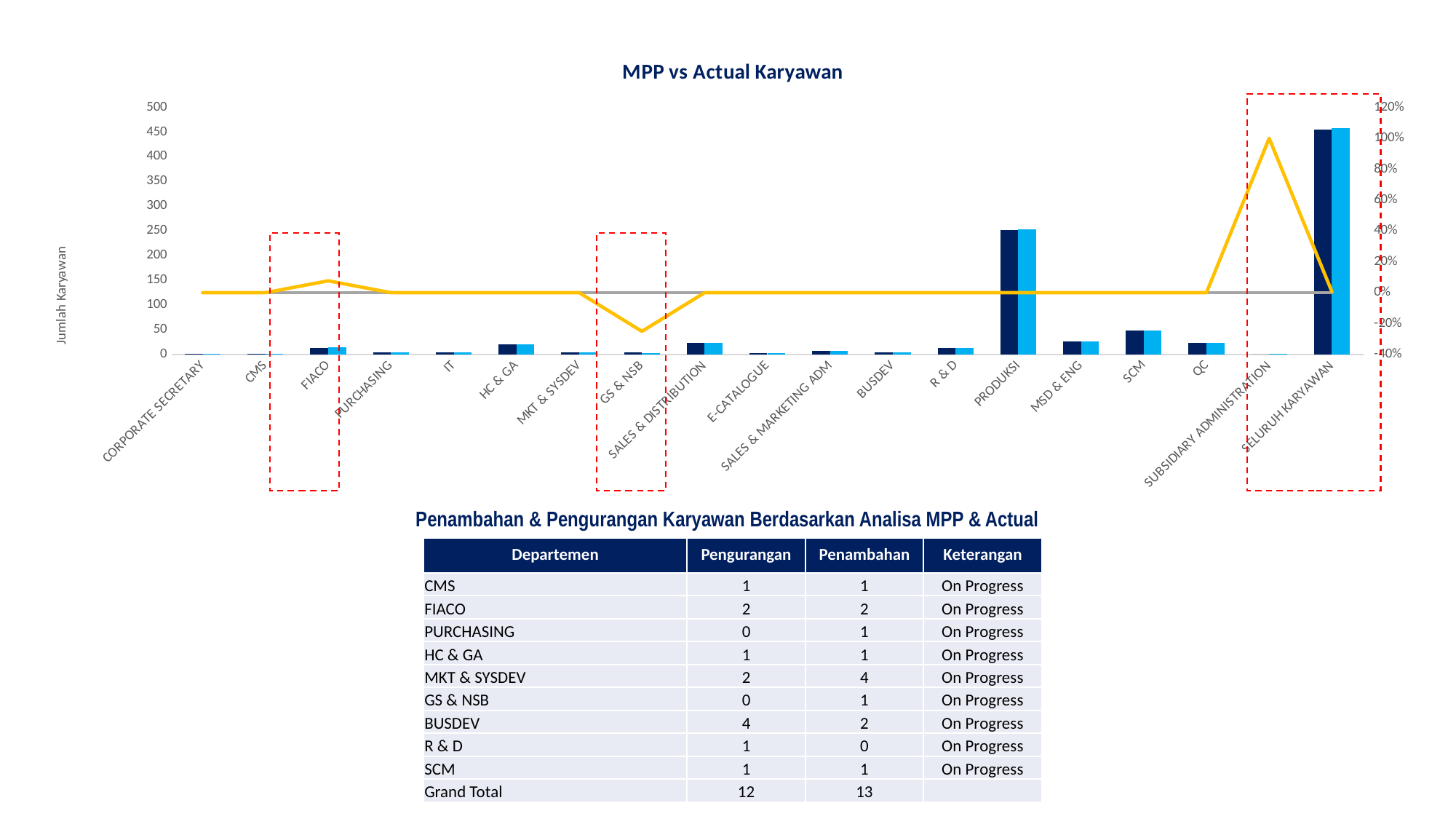
In the 'MPP vs Actual Karyawan' chart, are the bars for PRODUKSI greater or less than 200? greater In the 'MPP vs Actual Karyawan' chart, at which category does the yellow line reach its highest point? SUBSIDIARY ADMINISTRATION In the 'MPP vs Actual Karyawan' chart, are the bars for SELURUH KARYAWAN greater or less than 400? greater What kind of chart is 'MPP vs Actual Karyawan'? A combination bar and line chart What is the highest tick value shown on the right-hand percentage axis of the 'MPP vs Actual Karyawan' chart? 120% What is the label on the left vertical axis of the 'MPP vs Actual Karyawan' chart? Jumlah Karyawan In the 'MPP vs Actual Karyawan' chart, is the yellow line value for GS & NSB greater or less than 0%? less In the 'MPP vs Actual Karyawan' chart, which has taller bars, PRODUKSI or SCM? PRODUKSI How many categories are shown on the x axis of the 'MPP vs Actual Karyawan' chart? 19 In the 'MPP vs Actual Karyawan' chart, at which category does the yellow line reach its lowest point? GS & NSB Which category has the tallest bars in the 'MPP vs Actual Karyawan' chart? SELURUH KARYAWAN